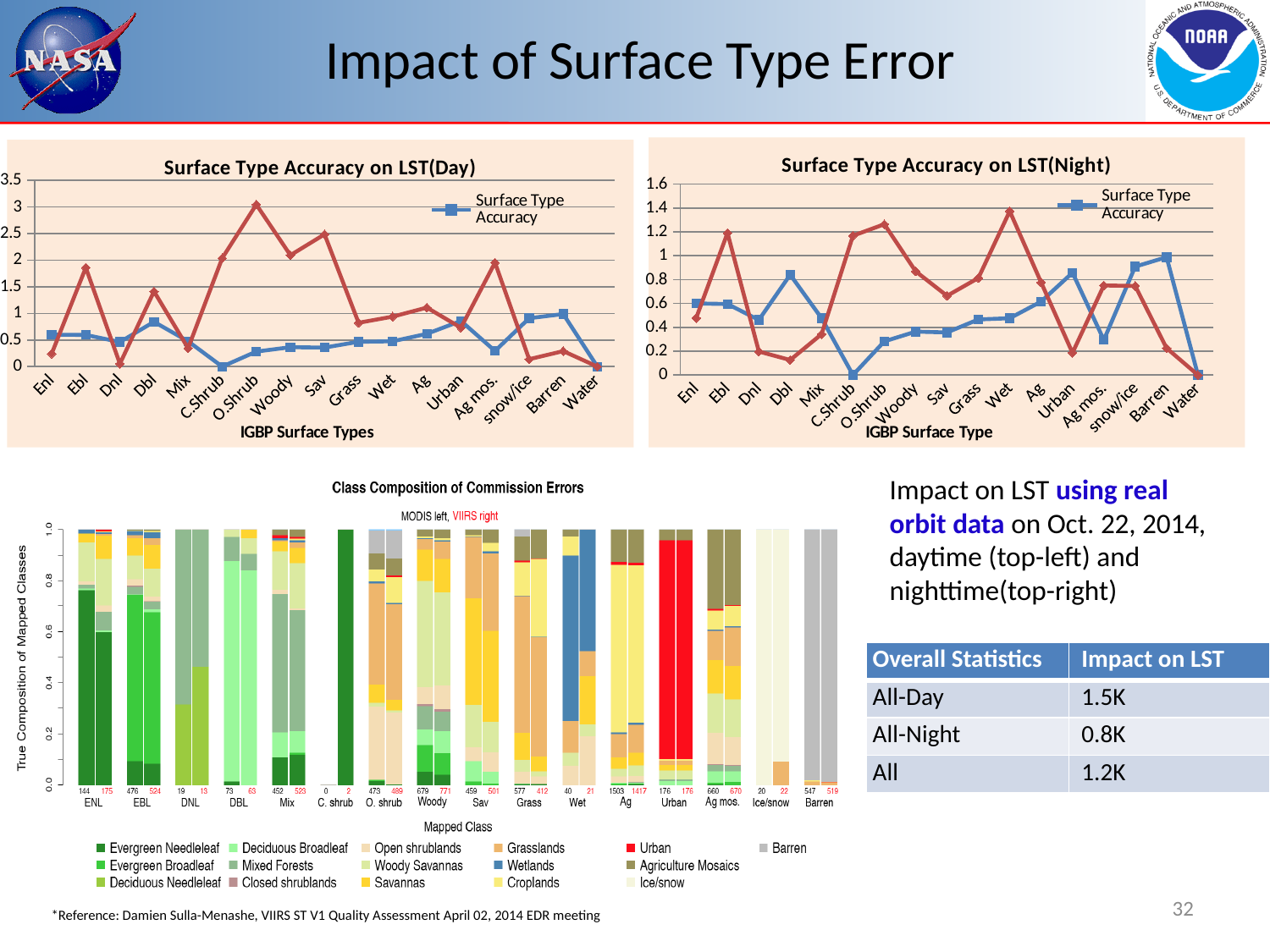
In the 'Surface Type Accuracy on LST(Day)' chart, is the red line value for O.Shrub greater or less than 2.5? greater In the 'Surface Type Accuracy on LST(Day)' chart, at which surface type does the red line reach its highest value? O.Shrub In the 'Surface Type Accuracy on LST(Night)' chart, which has the larger Surface Type Accuracy (blue line) value, Barren or Ag mos.? Barren In the 'Surface Type Accuracy on LST(Night)' chart, what is the Surface Type Accuracy (blue line) value for C.Shrub? 0 In the 'Surface Type Accuracy on LST(Day)' chart, what is the Surface Type Accuracy (blue line) value for Water? 0 What kind of chart is the 'Surface Type Accuracy on LST(Day)' chart? line chart In the 'Surface Type Accuracy on LST(Night)' chart, is the red line value for Wet greater or less than 1.2? greater In the 'Surface Type Accuracy on LST(Day)' chart, is the Surface Type Accuracy (blue line) value for Barren greater or less than 0.5? greater In the 'Surface Type Accuracy on LST(Night)' chart, at which surface type does the red line reach its highest value? Wet How many IGBP surface type categories are shown on the x axis of the 'Surface Type Accuracy on LST(Day)' chart? 17 What kind of chart is the 'Class Composition of Commission Errors' chart? stacked bar chart How many entries does the legend of the 'Class Composition of Commission Errors' chart list? 16